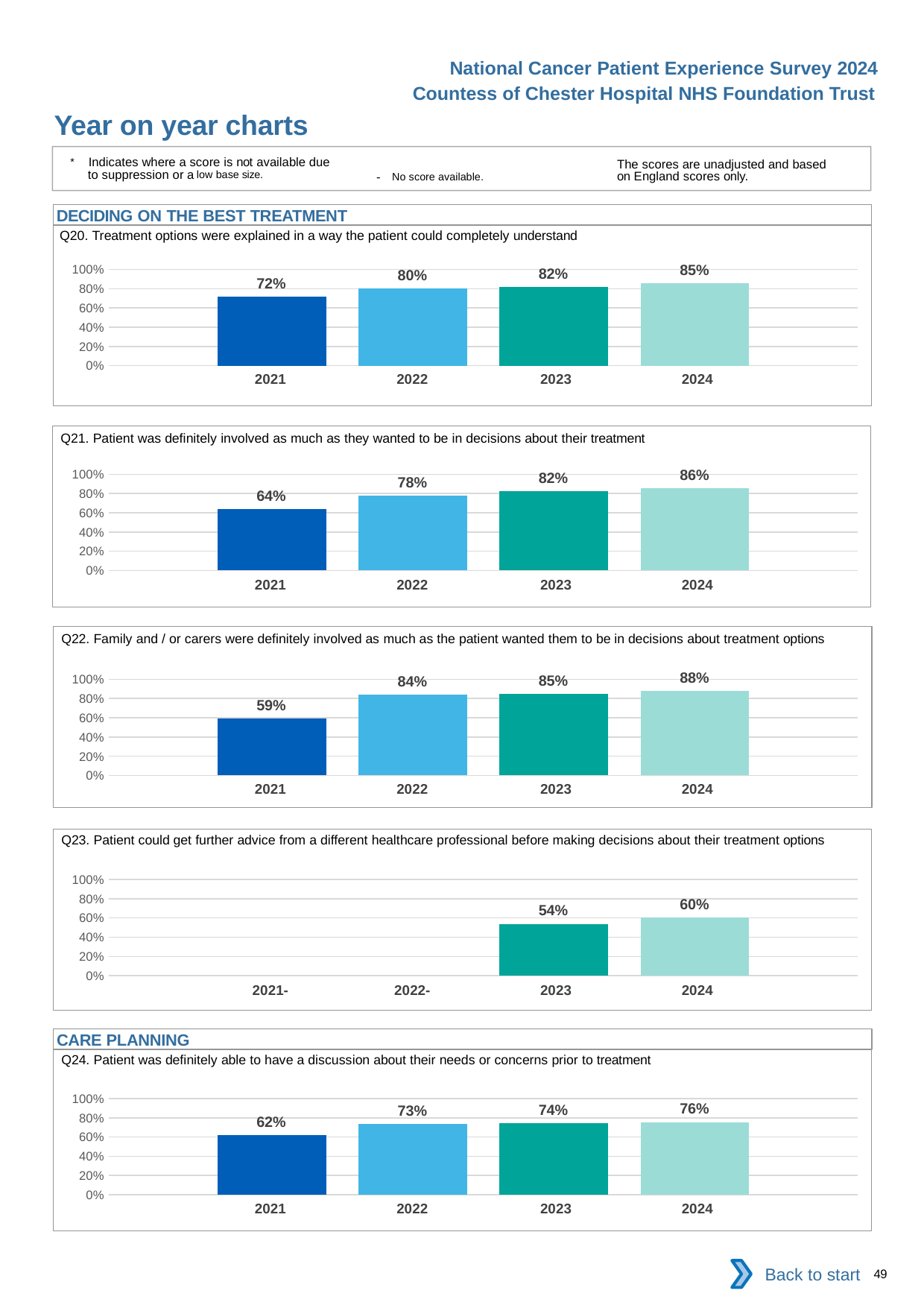
In the Q23 chart, what is the value for 2023? 54% In the Q20 chart, what is the difference between the 2022 and 2021 values? 8 percentage points In the Q21 chart, is the value for 2022 larger or smaller than the value for 2023? smaller Which section heading appears above the Q24 chart? CARE PLANNING In the Q22 chart, what is the difference between the 2024 and 2021 values? 29 percentage points In the Q21 chart, which year has the lowest value? 2021 In the Q20 chart, do the values rise or fall from 2021 to 2024? rise In the Q24 chart, what is the value for 2022? 73% In the Q20 chart, what is the value for 2024? 85% In the Q23 chart, how many years have a plotted bar? 2 In the Q24 chart, which year has the highest value? 2024 What kind of chart is the Q22 chart? bar chart